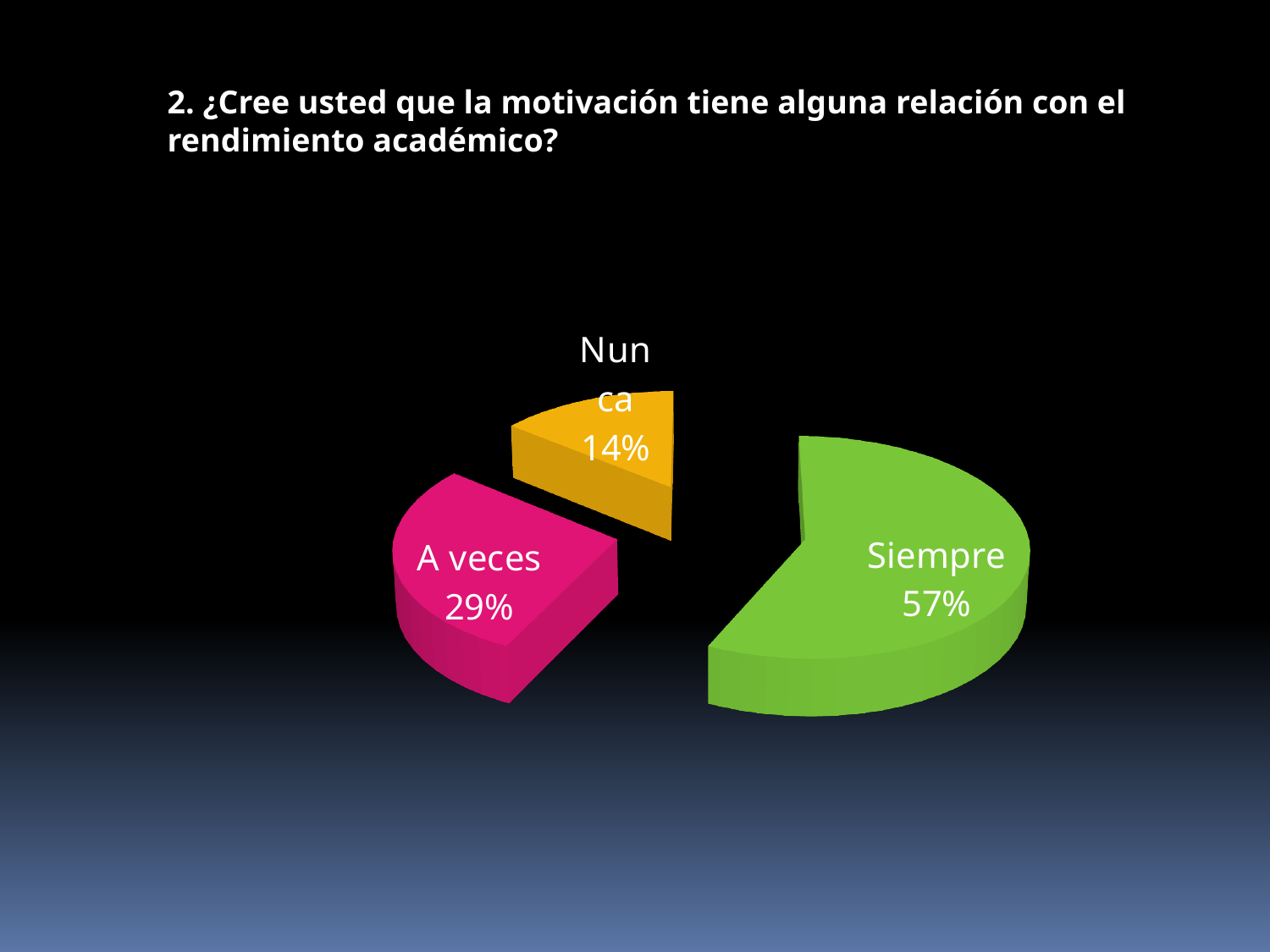
Which category has the smallest slice of the pie? Nunca What colour is the Siempre slice? Green What kind of chart is shown on the slide? Pie chart How many categories are shown in the pie chart? 3 Which is larger, A veces or Nunca? A veces What colour is the A veces slice? Pink What share of the pie does Siempre represent? 57% Which category has the largest slice of the pie? Siempre What is the value shown for Nunca? 14% What is the value shown for A veces? 29% What is the difference between the Siempre and A veces percentages? 28% What is the difference between the A veces and Nunca percentages? 15%